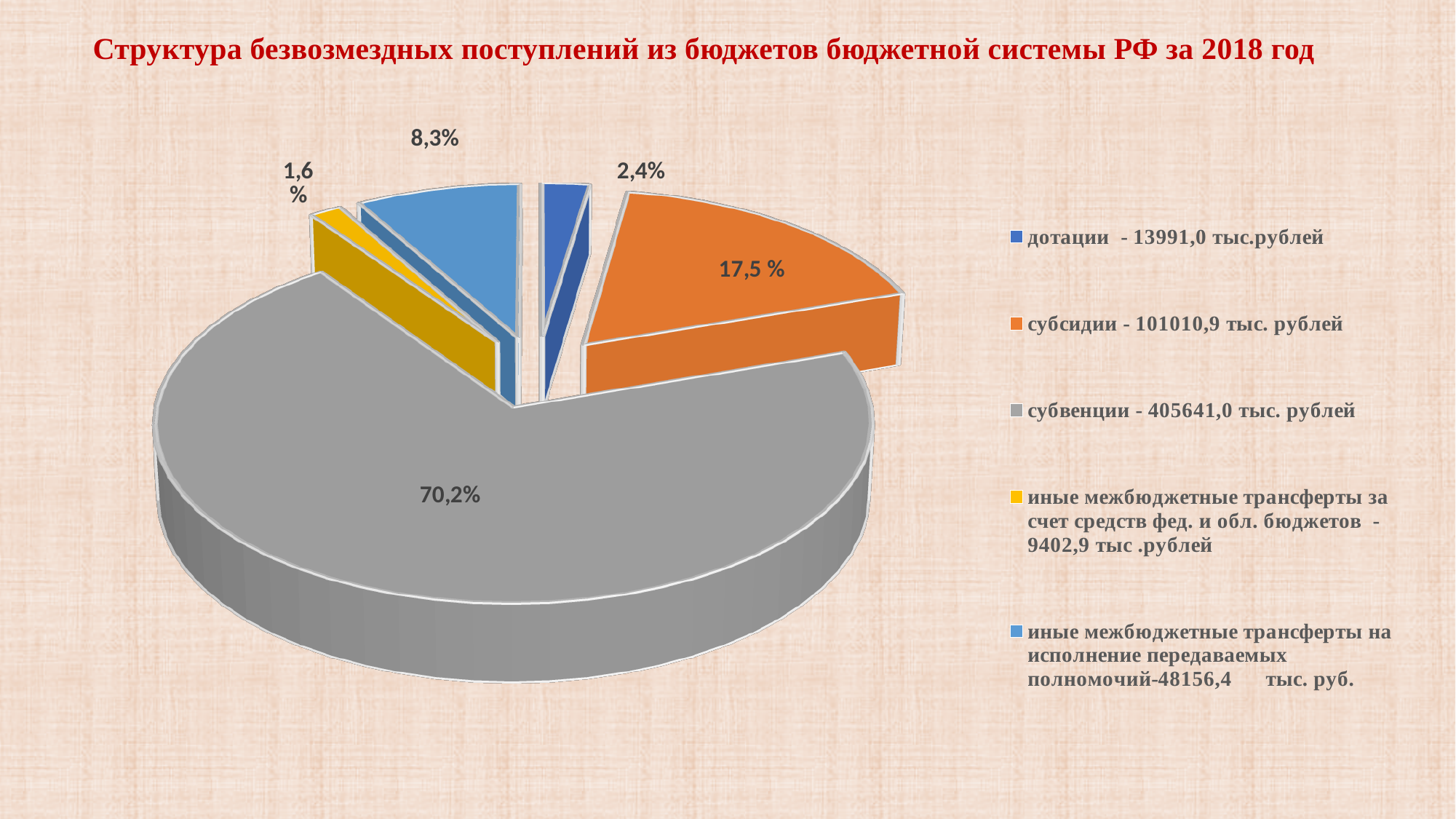
What share of the pie does the слice for субвенции represent? 70,2% What kind of chart is shown on the slide? pie chart According to the legend, what amount in тыс. рублей is given for субвенции? 405641,0 тыс. рублей What percentage is shown for дотации? 2,4% What percentage is shown for иные межбюджетные трансферты на исполнение передаваемых полномочий? 8,3% What percentage is shown for субсидии? 17,5 % How many categories does the pie chart have? 5 Which category has the smallest slice of the pie? иные межбюджетные трансферты за счет средств фед. и обл. бюджетов Which is larger, the share for субсидии or the share for дотации? субсидии What is the difference in percentage points between the share for субвенции and the share for субсидии? 52,7 Which category has the largest slice of the pie? субвенции What is the title of the chart? Структура безвозмездных поступлений из бюджетов бюджетной системы РФ за 2018 год